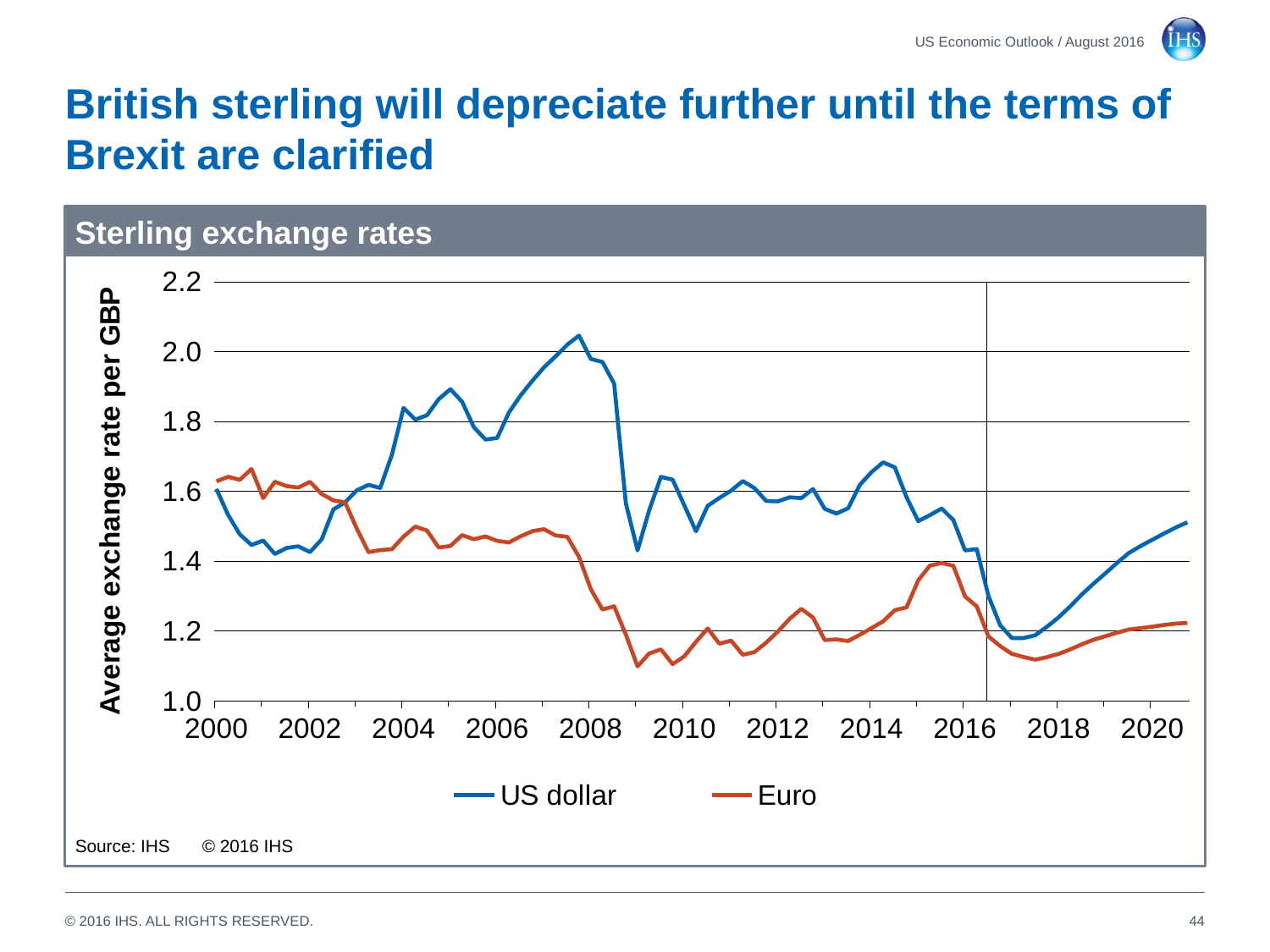
What kind of chart is shown on the slide? Line chart Is the value for the Euro in 2009 greater or less than 1.2? less How many series does the legend list? 2 In 2008, which series has the higher value, US dollar or Euro? US dollar In 2002, which series has the higher value, US dollar or Euro? Euro Does the Euro series rise or fall between 2008 and 2009? fall Is the value for the Euro in 2000 greater or less than 1.4? greater Is the value for the US dollar in 2008 greater or less than 1.8? greater What is the title of the chart? Sterling exchange rates Does the US dollar series rise or fall between 2017 and 2020? rise What is the label on the vertical axis of the chart? Average exchange rate per GBP